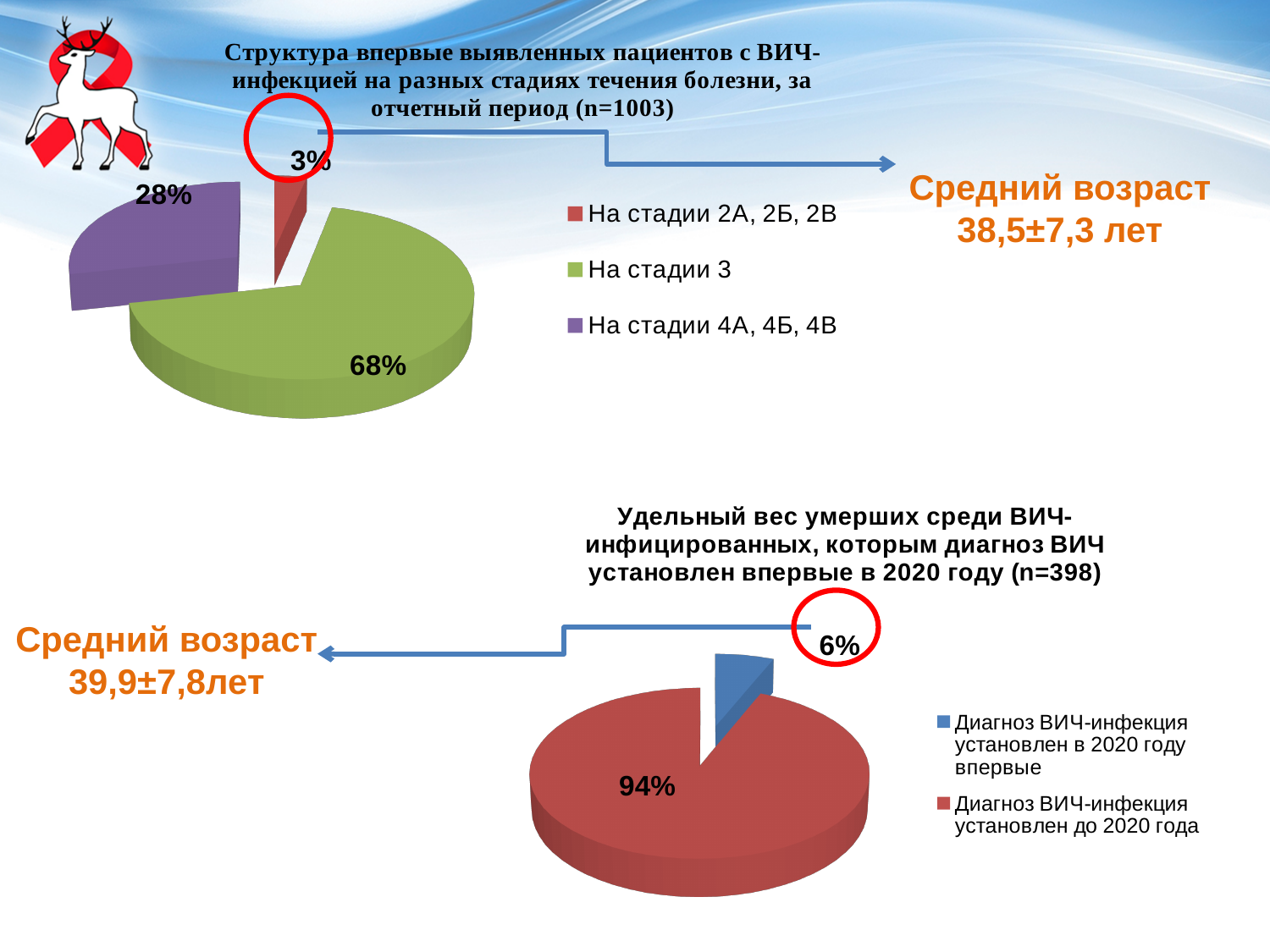
In the top pie chart, what is the difference in percentage points between 'На стадии 3' and 'На стадии 4А, 4Б, 4В'? 40 In the top pie chart, which category has the largest slice? На стадии 3 In the top pie chart, what share is labelled for 'На стадии 4А, 4Б, 4В'? 28% How many categories does the legend of the top pie chart list? 3 In the bottom pie chart, what colour is the slice for 'Диагноз ВИЧ-инфекция установлен до 2020 года'? Red In the bottom pie chart, which category is larger: 'Диагноз ВИЧ-инфекция установлен в 2020 году впервые' or 'Диагноз ВИЧ-инфекция установлен до 2020 года'? Диагноз ВИЧ-инфекция установлен до 2020 года In the top pie chart, what share is labelled for 'На стадии 2А, 2Б, 2В'? 3% What type of chart is the top chart on the slide? Pie chart In the bottom pie chart, what share is labelled for 'Диагноз ВИЧ-инфекция установлен до 2020 года'? 94% In the bottom pie chart (Удельный вес умерших среди ВИЧ-инфицированных...), what share is labelled for 'Диагноз ВИЧ-инфекция установлен в 2020 году впервые'? 6% In the top pie chart (Структура впервые выявленных пациентов с ВИЧ-инфекцией...), what share is labelled for 'На стадии 3'? 68% In the top pie chart, which category has the smallest slice? На стадии 2А, 2Б, 2В